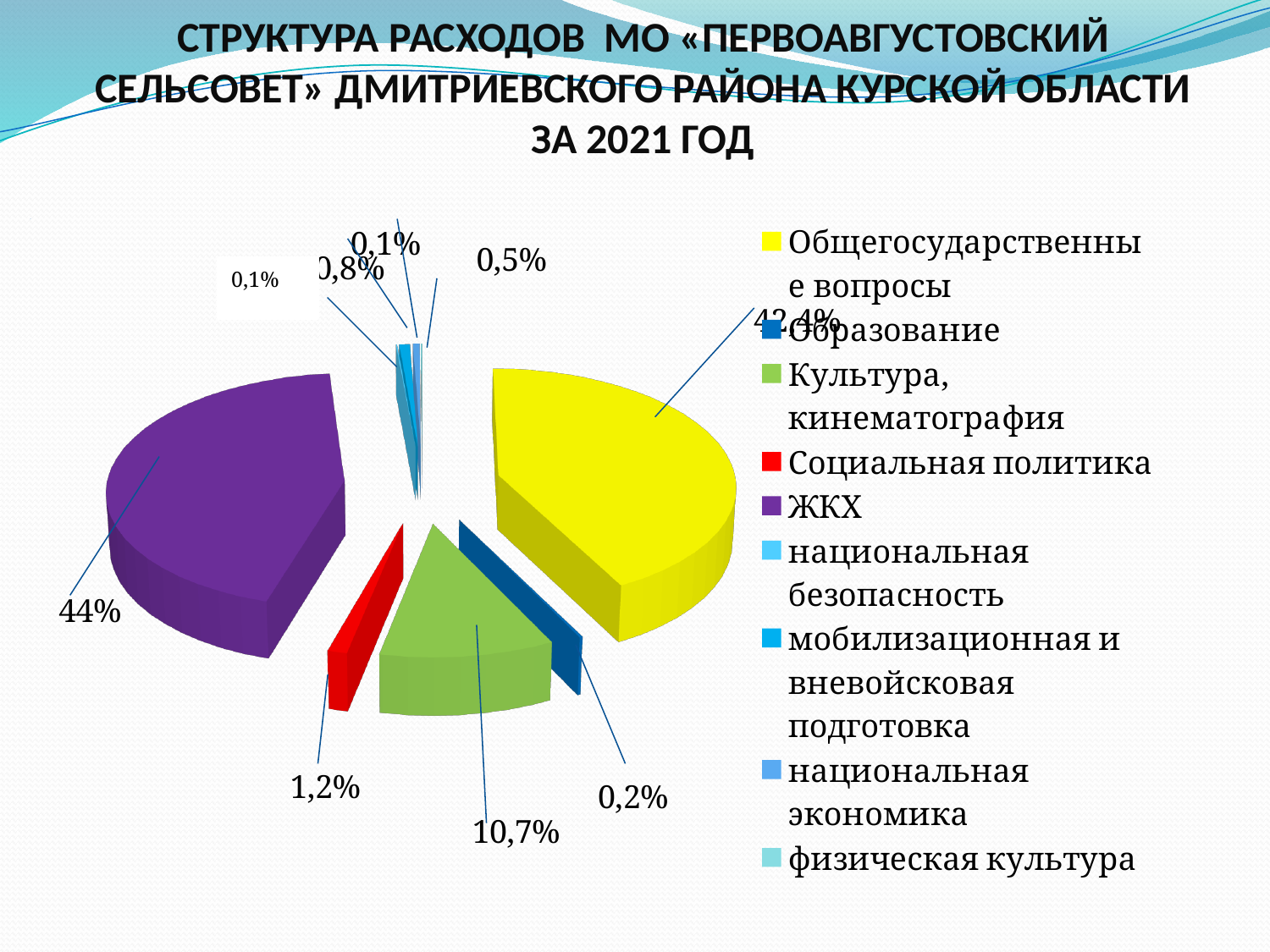
What is the difference between the shares for Культура, кинематография and Социальная политика? 9,5% Which is larger: the share for ЖКХ or the share for Общегосударственные вопросы? ЖКХ Which is larger: the share for Культура, кинематография or the share for Социальная политика? Культура, кинематография What is the value shown for Социальная политика? 1,2% What colour is the ЖКХ slice in the pie chart? purple What is the value shown for Образование? 0,2% Which category has the largest share of the pie? ЖКХ What kind of chart is shown on the slide? pie chart What is the difference between the shares for ЖКХ and Культура, кинематография? 33,3% How many categories does the legend of the pie chart list? 9 What is the value shown for Культура, кинематография? 10,7% What share of expenditures does ЖКХ account for? 44%